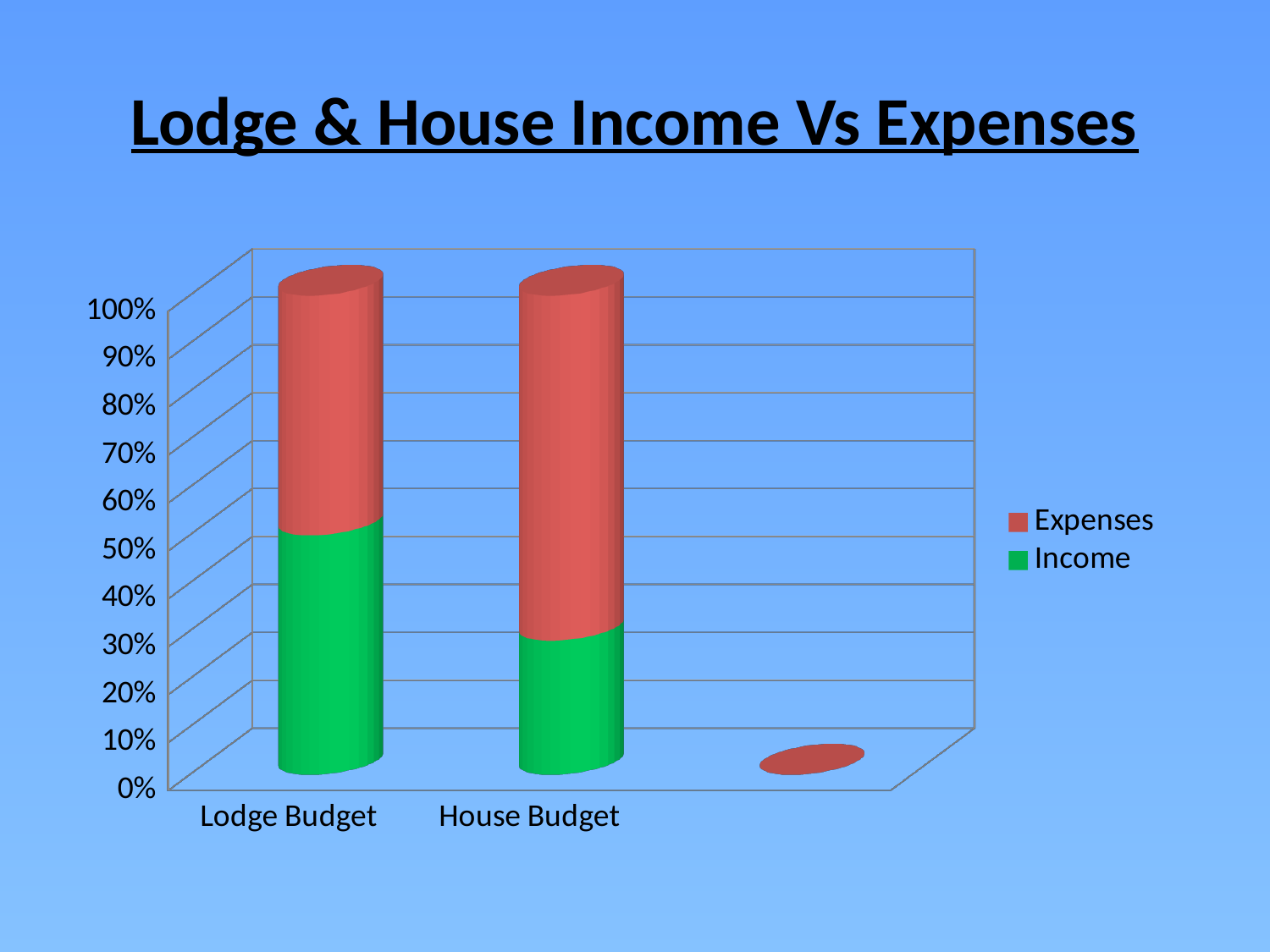
What is the title of the chart? Lodge & House Income Vs Expenses How many series does the legend list? 2 What is the total height of the stacked bar for Lodge Budget? 100% Is the Income share for Lodge Budget greater or less than 40%? greater Which category has the larger Income share, Lodge Budget or House Budget? Lodge Budget Is the Income share for House Budget greater or less than 20%? greater What type of chart is shown on the slide? Stacked bar chart How many labelled categories are shown on the x axis? 2 Is the Income share for House Budget greater or less than 40%? less Which series is shown in green? Income Which category has the larger Expenses share, Lodge Budget or House Budget? House Budget Which category has the lowest Income share? House Budget